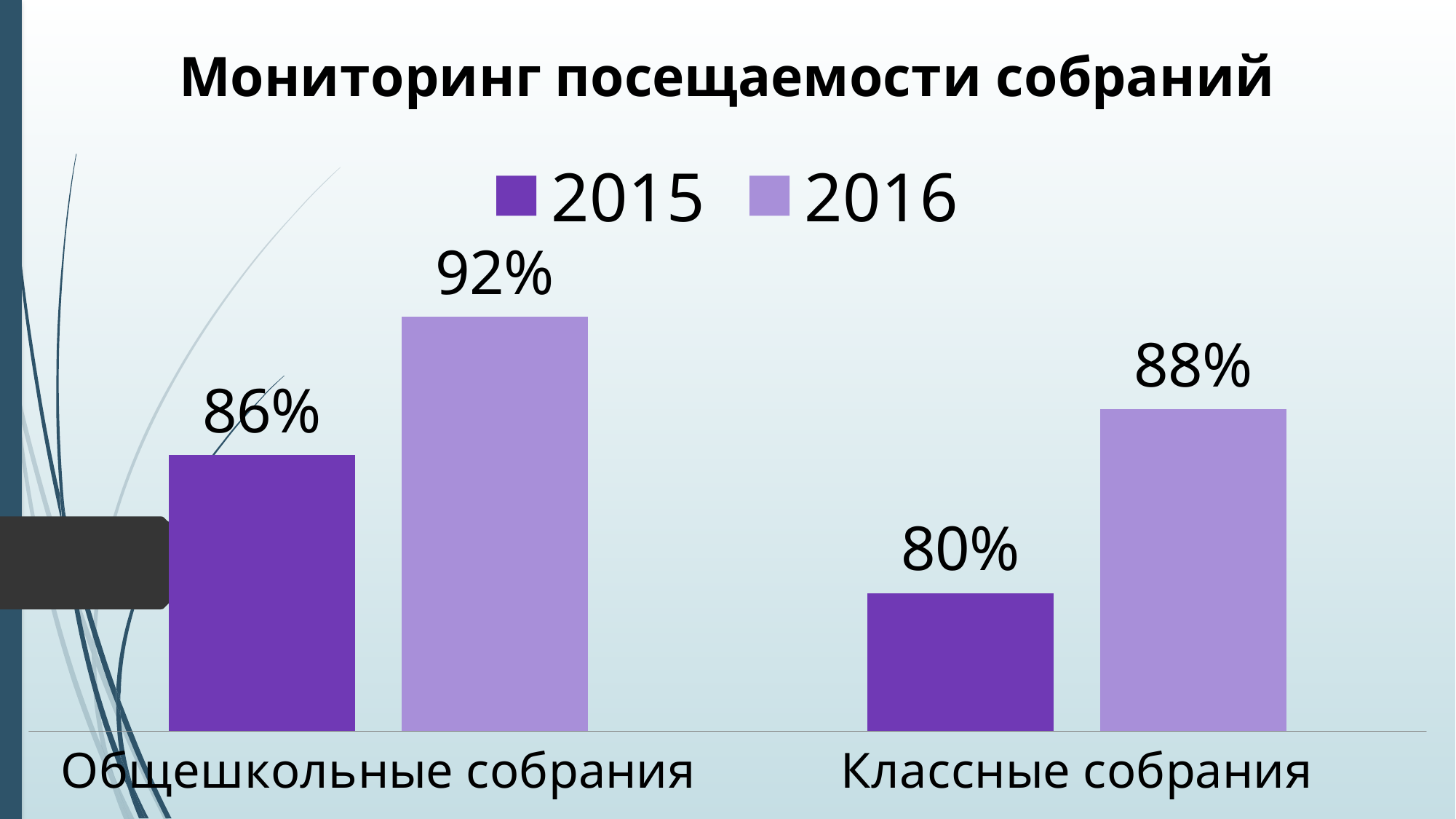
What is the difference between the 2016 and 2015 values for Общешкольные собрания? 6% How many categories are shown on the x axis? 2 What is the value for Классные собрания in 2016? 88% What is the value for Общешкольные собрания in 2015? 86% What kind of chart is shown on the slide? Bar chart How many series does the legend list? 2 What is the value for Общешкольные собрания in 2016? 92% What is the difference between the 2016 and 2015 values for Классные собрания? 8% Which category has the highest value in 2016? Общешкольные собрания What is the value for Классные собрания in 2015? 80% Which is larger: the 2015 value for Общешкольные собрания or the 2016 value for Классные собрания? 2016 value for Классные собрания Which category has the lowest value in 2015? Классные собрания